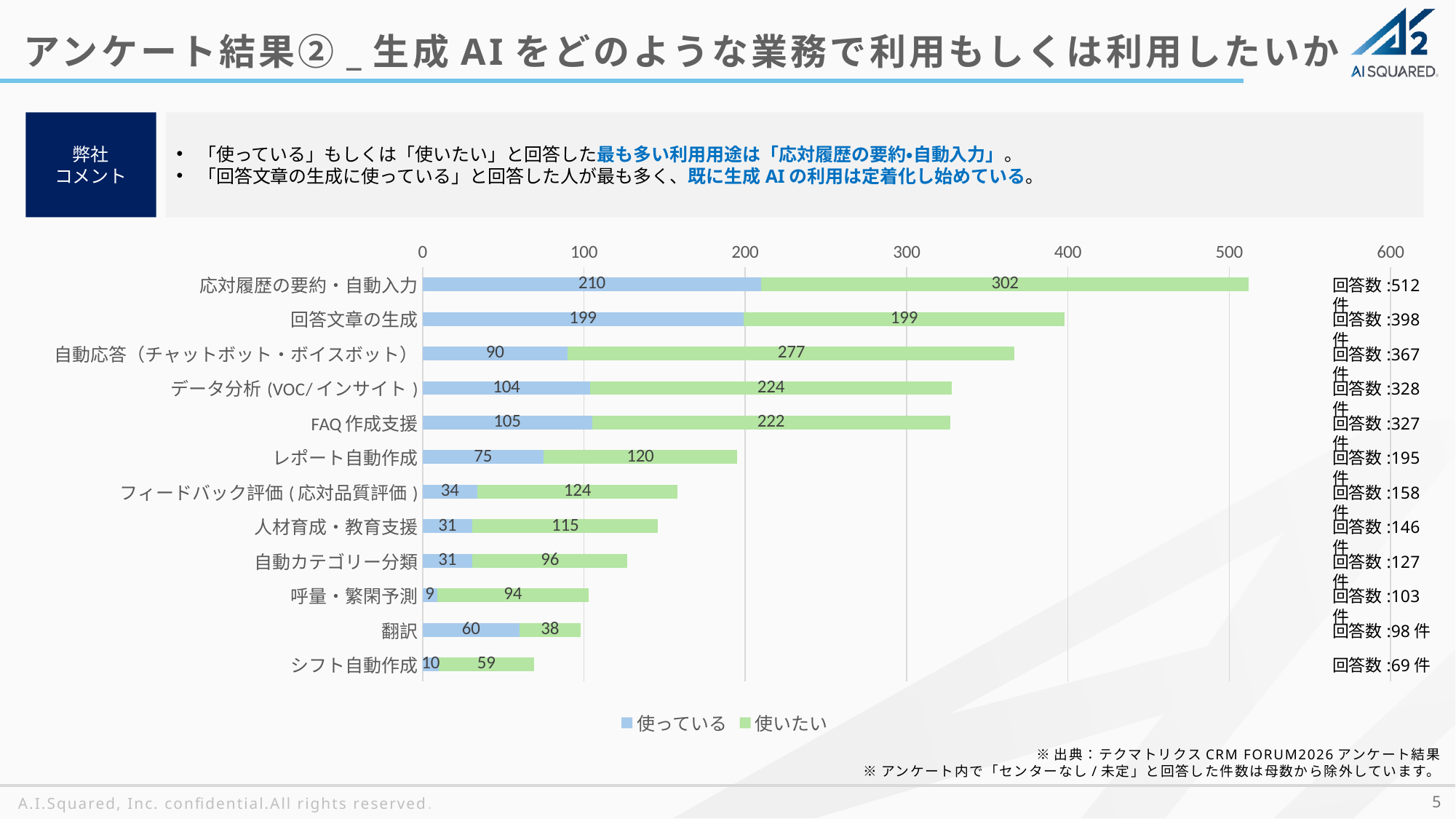
What is the 使いたい value for 自動応答（チャットボット・ボイスボット）? 277 Which is larger: the 使っている value for FAQ 作成支援 or for データ分析 (VOC/ インサイト )? FAQ 作成支援 Which category has the highest 使いたい value? 応対履歴の要約・自動入力 Which series is shown in green in the legend? 使いたい What is the total of the stacked bar for データ分析 (VOC/ インサイト )? 328 What is the difference between the 使いたい values for 応対履歴の要約・自動入力 and 回答文章の生成? 103 What is the 使っている value for 翻訳? 60 What kind of chart is shown on the slide? Stacked bar chart How many categories are plotted on the chart? 12 How many series does the legend list? 2 Which category has the lowest 使っている value? 呼量・繁閑予測 What is the 使っている value for 応対履歴の要約・自動入力? 210